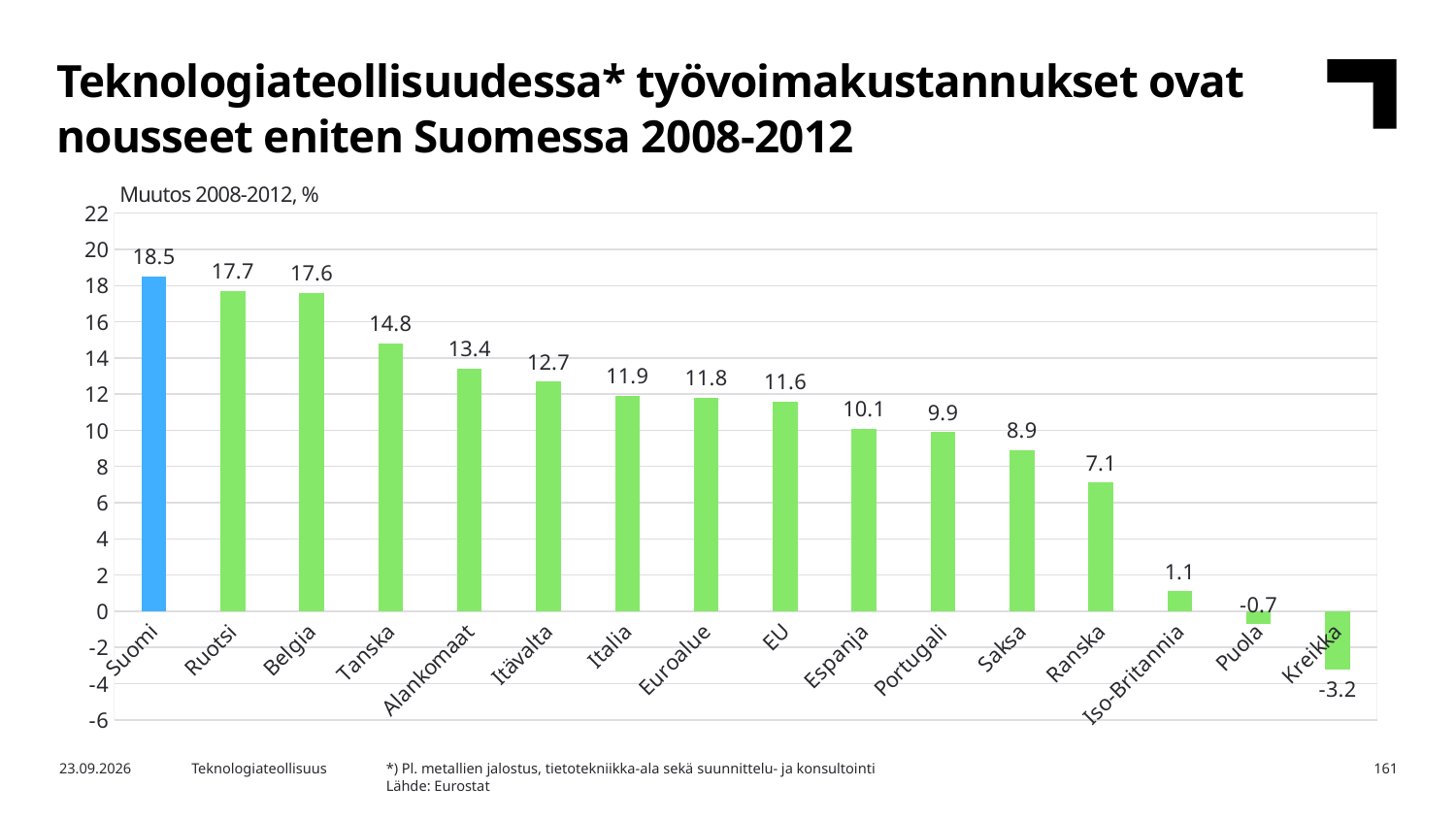
Which is larger, the value for Espanja or the value for Portugali? Espanja How many categories are shown on the x axis? 16 Which category has the lowest value? Kreikka What is the difference between the values for Suomi and Ruotsi? 0.8 Which country has the highest value? Suomi Do the values rise or fall from left to right along the x axis? Fall What is the value for Kreikka? -3.2 What is the difference between the values for Tanska and Saksa? 5.9 What kind of chart is shown on the slide? Bar chart What is the value for Iso-Britannia? 1.1 What is the value for Suomi? 18.5 What is the value for Alankomaat? 13.4